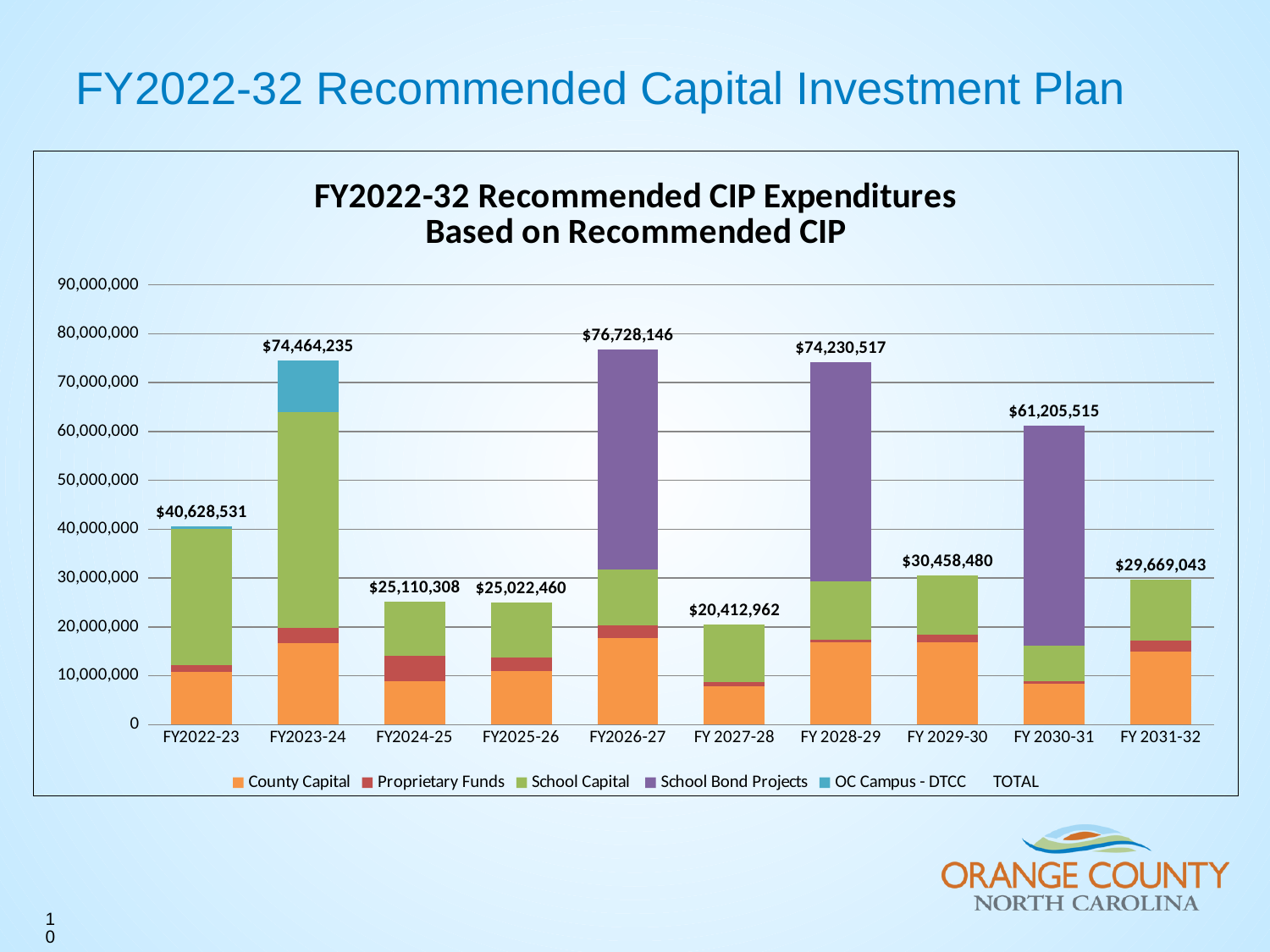
Which fiscal year has the lowest total CIP expenditure? FY 2027-28 How many entries does the legend list? 6 What is the total labelled for FY 2027-28? $20,412,962 Is the County Capital value for FY2026-27 greater or less than 20,000,000? less What is the total labelled for FY 2030-31? $61,205,515 Which fiscal year has the highest total CIP expenditure? FY2026-27 What is the total labelled for FY2026-27? $76,728,146 What is the difference between the totals for FY2023-24 and FY2022-23? $33,835,704 What kind of chart is shown? Stacked bar chart Which has the larger total, FY 2029-30 or FY 2031-32? FY 2029-30 What is the difference between the totals for FY2026-27 and FY 2028-29? $2,497,629 How many fiscal years are shown on the x axis? 10